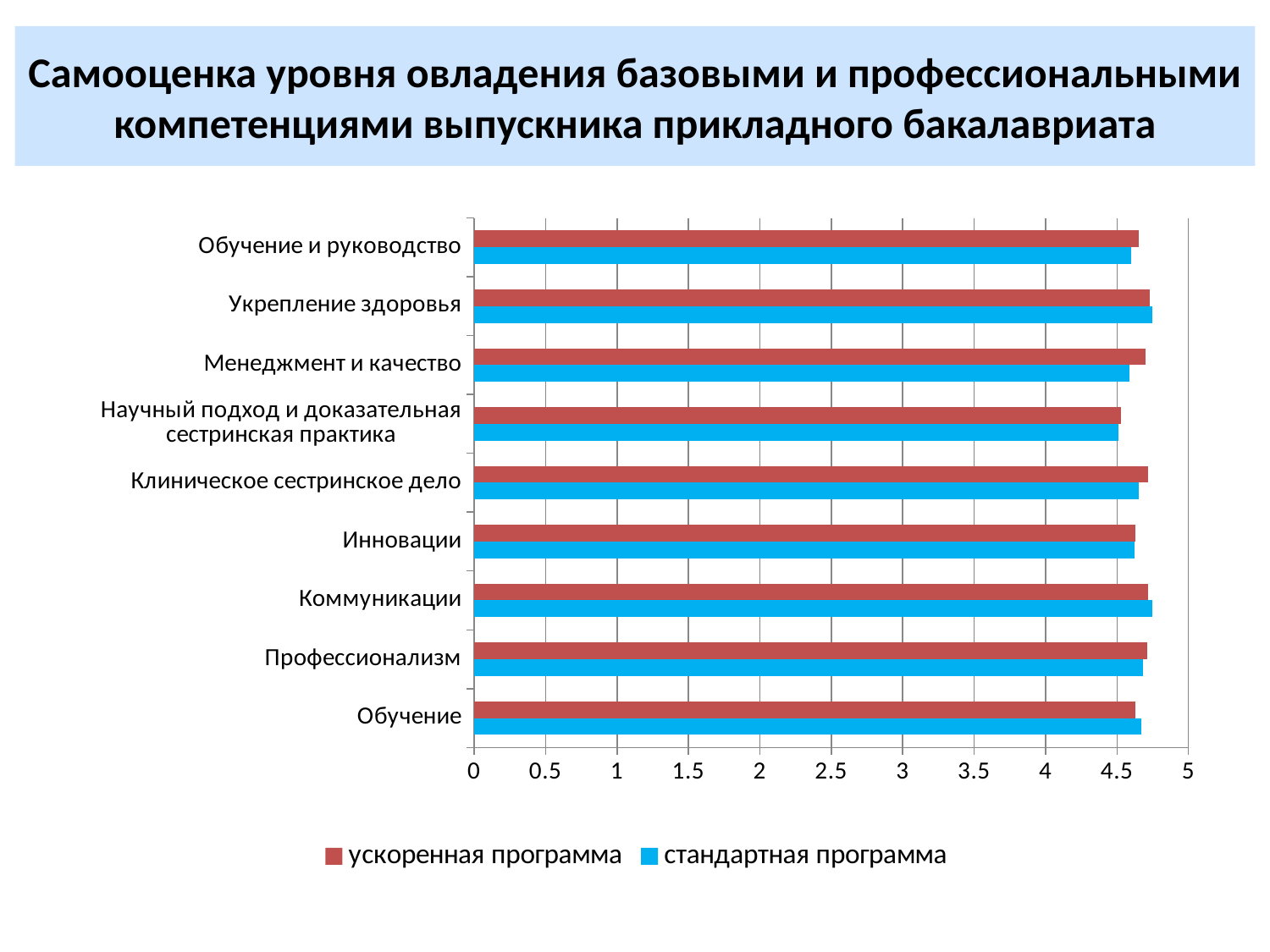
Is the value for Укрепление здоровья in the ускоренная программа series greater or less than 4.5? greater How many series does the legend list? 2 What is the maximum value shown on the horizontal axis? 5 Which colour represents стандартная программа in the legend? blue Which category has the lowest value for стандартная программа? Научный подход и доказательная сестринская практика Is the value for Коммуникации in the стандартная программа series greater or less than 4.5? greater In the стандартная программа series, which is larger: Коммуникации or Научный подход и доказательная сестринская практика? Коммуникации What kind of chart is shown on the slide? bar chart How many competency categories are plotted on the chart? 9 Which category has the lowest value for ускоренная программа? Научный подход и доказательная сестринская практика For Менеджмент и качество, which series has the larger value: ускоренная программа or стандартная программа? ускоренная программа Is the value for Обучение in the ускоренная программа series greater or less than 4? greater